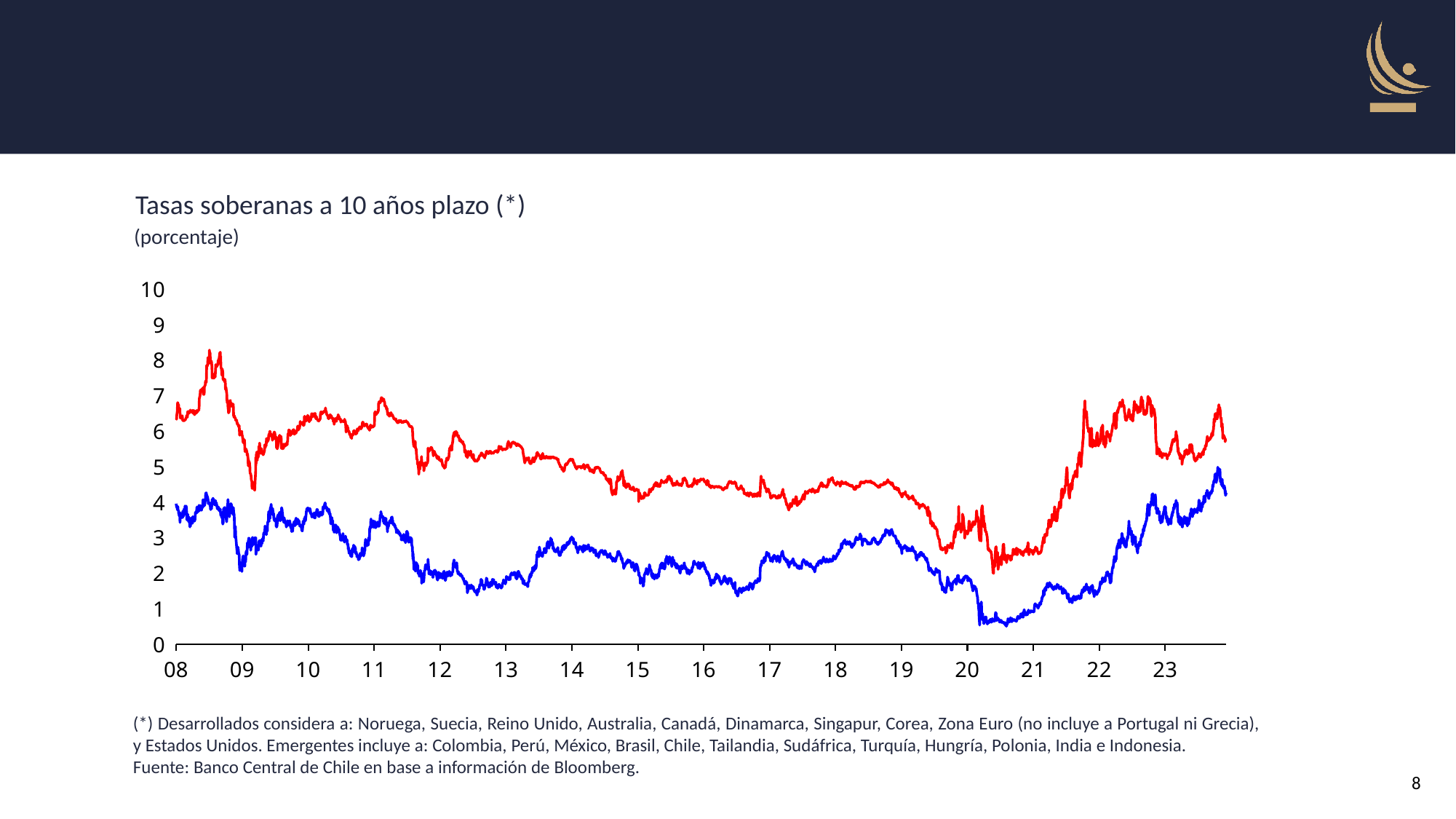
What is the title of the chart? Tasas soberanas a 10 años plazo (*) Is the lowest point of the blue line around 2020 greater or less than 1? less In what unit are the values on the chart expressed, according to the subtitle? porcentaje Which line is higher across the whole period, the red line or the blue line? red line What type of chart is shown on the slide? line chart Does the blue line rise or fall between 2021 and 2023? rise Does the red line rise or fall between 2011 and 2016? fall Is the peak of the red line in 2008 greater or less than 8? greater Is the value of the blue line at the start of 2008 greater or less than 3? greater How many lines are plotted on the chart? 2 How many year labels are shown on the x axis? 16